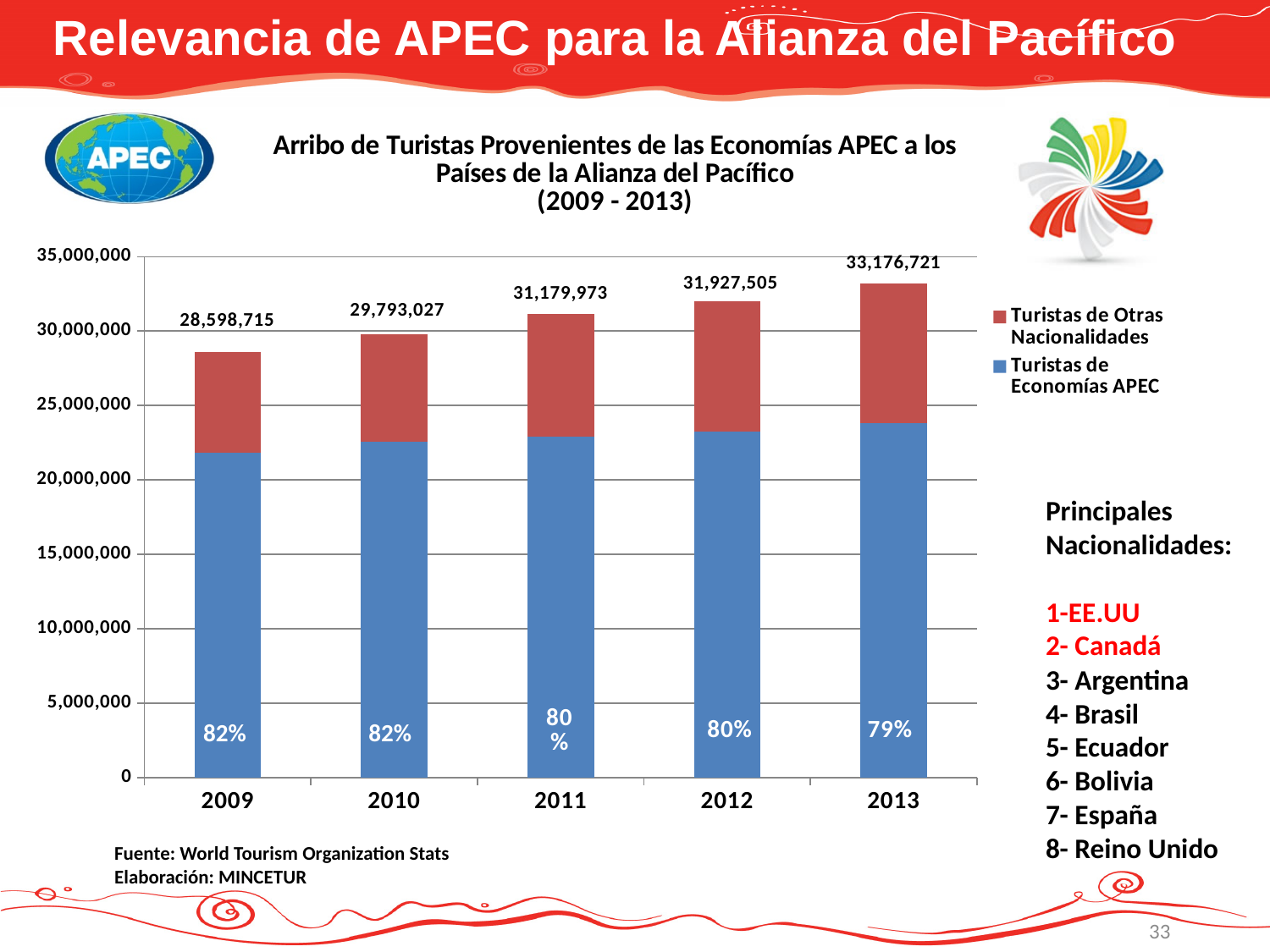
What is the difference between the total tourist arrivals in 2012 and in 2011? 747,532 What is the total number of tourist arrivals shown for 2013? 33,176,721 What percentage of tourists in 2011 came from APEC economies, according to the label on the bar? 80% Do the total tourist arrivals rise or fall from 2009 to 2013? rise How many years are shown on the x axis of the chart? 5 Which year has the lowest total of tourist arrivals? 2009 How many series does the legend list? 2 Is the value for Turistas de Economías APEC in 2009 greater or less than 20,000,000? greater What is the total number of tourist arrivals shown for 2009? 28,598,715 Which year has the highest total of tourist arrivals? 2013 What is the difference between the total tourist arrivals in 2013 and in 2009? 4,578,006 Which year has a larger total of tourist arrivals, 2010 or 2011? 2011